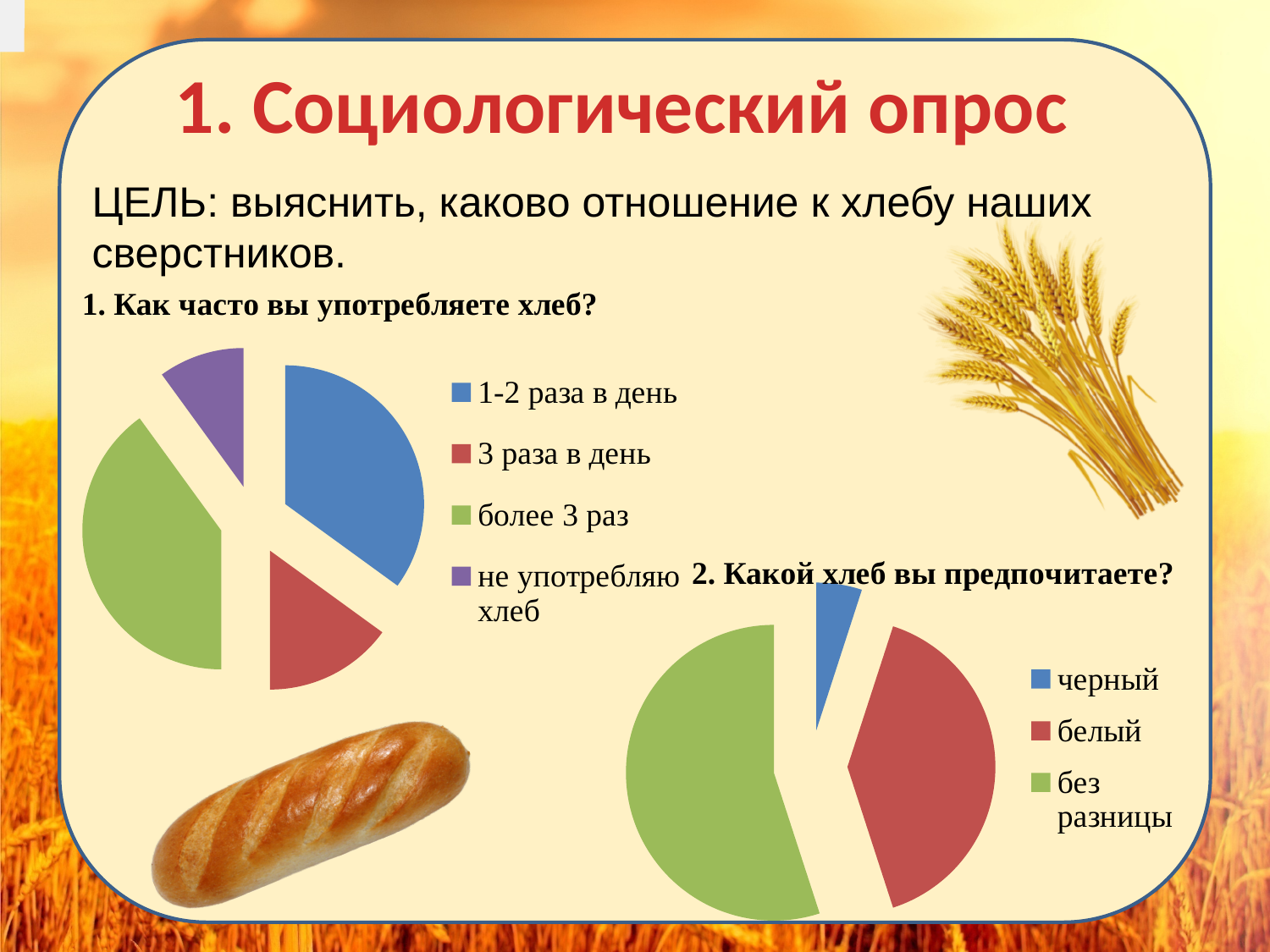
In the chart for "Какой хлеб вы предпочитаете?", which slice is larger: "белый" or "черный"? белый In the chart for "Какой хлеб вы предпочитаете?", which category has the smallest slice? черный In the chart for "Какой хлеб вы предпочитаете?", how many categories does the legend list? 3 In the chart for "Как часто вы употребляете хлеб?", what colour represents "более 3 раз"? green What kind of chart is used for question 1, "Как часто вы употребляете хлеб?"? pie chart In the chart for "Как часто вы употребляете хлеб?", which slice is larger: "1-2 раза в день" or "3 раза в день"? 1-2 раза в день In the chart for "Какой хлеб вы предпочитаете?", what colour represents "белый"? red In the chart for "Как часто вы употребляете хлеб?", how many categories does the legend list? 4 What kind of chart is used for question 2, "Какой хлеб вы предпочитаете?"? pie chart In the chart for "Как часто вы употребляете хлеб?", which category has the smallest slice? не употребляю хлеб In the chart for "Какой хлеб вы предпочитаете?", which category has the largest slice? без разницы In the chart for "Как часто вы употребляете хлеб?", which slice is larger: "3 раза в день" or "не употребляю хлеб"? 3 раза в день